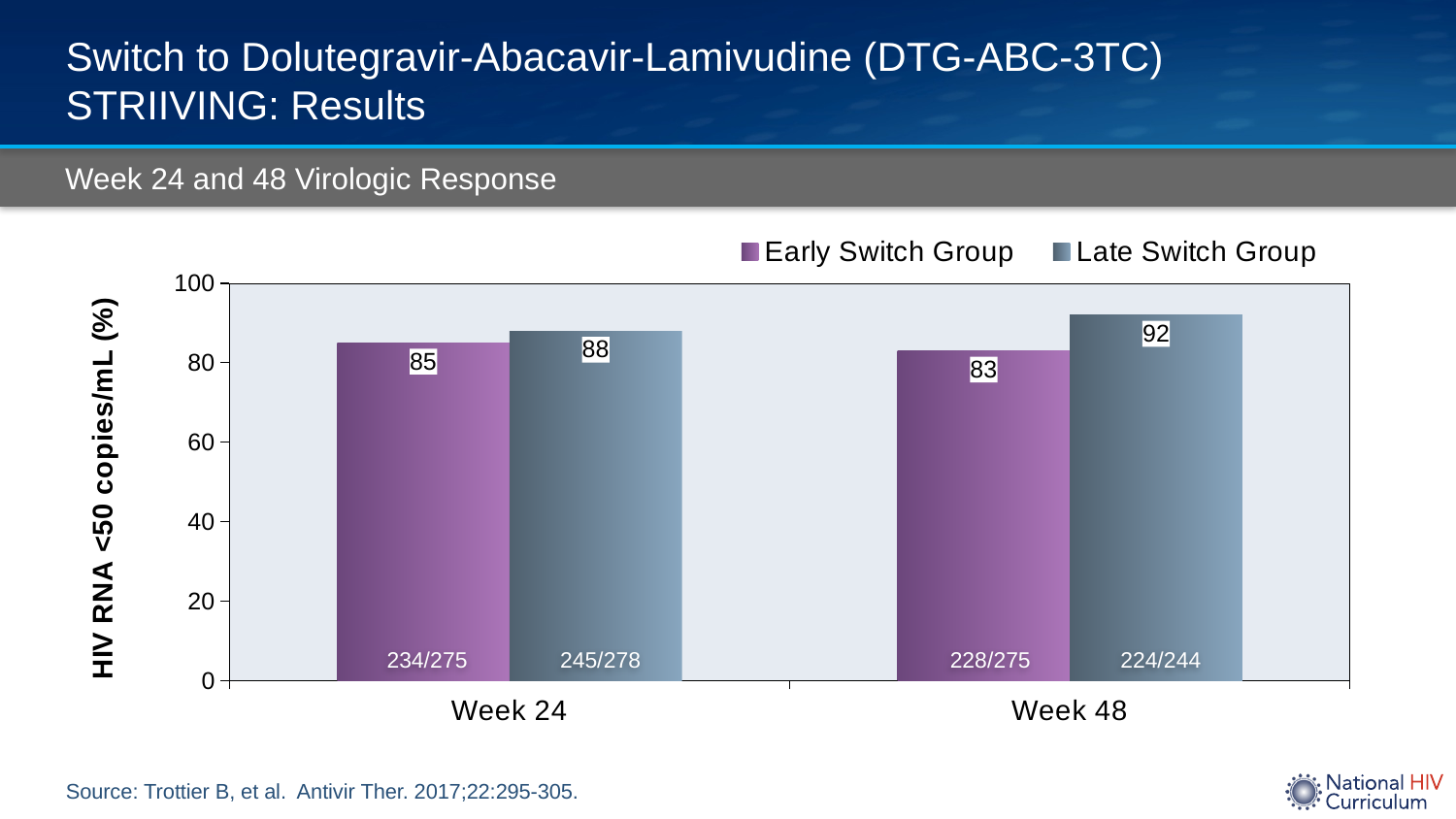
What is the value for the Early Switch Group at Week 24? 85 What is the value for the Late Switch Group at Week 24? 88 What is the value for the Early Switch Group at Week 48? 83 Which bar has the lowest value on the chart? Early Switch Group at Week 48 What kind of chart is shown on the slide? Bar chart Which bar has the highest value on the chart? Late Switch Group at Week 48 How many series does the legend list? 2 What is the difference between the Late Switch Group and Early Switch Group values at Week 24? 3 What is the value for the Late Switch Group at Week 48? 92 What is the y-axis label of the chart? HIV RNA <50 copies/mL (%) Which group has the higher value at Week 48? Late Switch Group What is the difference between the Late Switch Group and Early Switch Group values at Week 48? 9